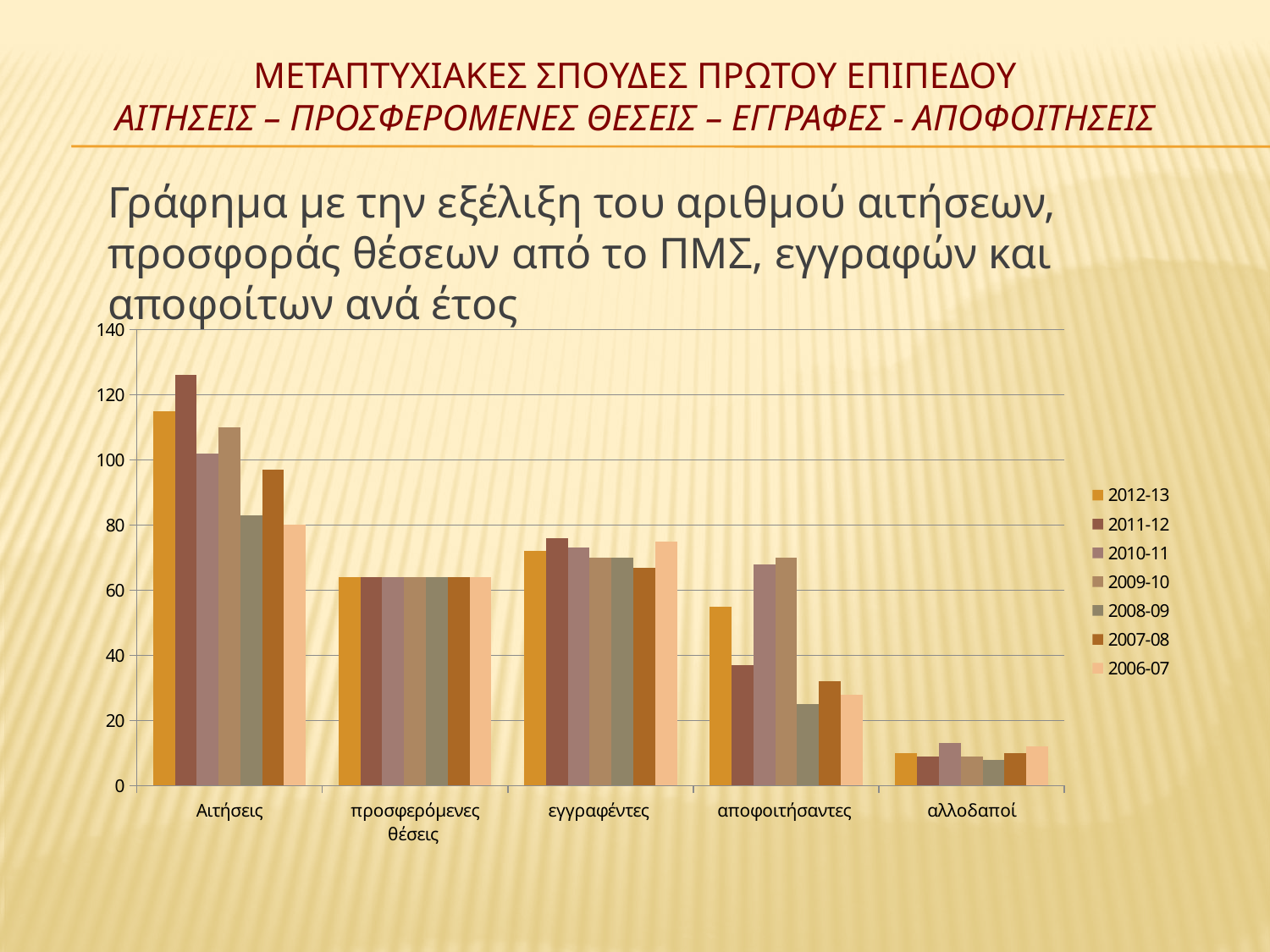
Is the value for 2012-13 in the Αιτήσεις category greater or less than 100? greater What kind of chart is shown on the slide? bar chart Is the value for 2012-13 in the προσφερόμενες θέσεις category greater or less than 60? greater How many series does the legend list? 7 In the αποφοιτήσαντες category, which is larger: the value for 2012-13 or the value for 2011-12? 2012-13 How many categories are shown on the x axis? 5 In the Αιτήσεις category, which is larger: the value for 2012-13 or the value for 2010-11? 2012-13 Is the value for 2011-12 in the Αιτήσεις category greater or less than 120? greater Which series has the highest value in the Αιτήσεις category? 2011-12 Which category contains the tallest bar in the chart? Αιτήσεις